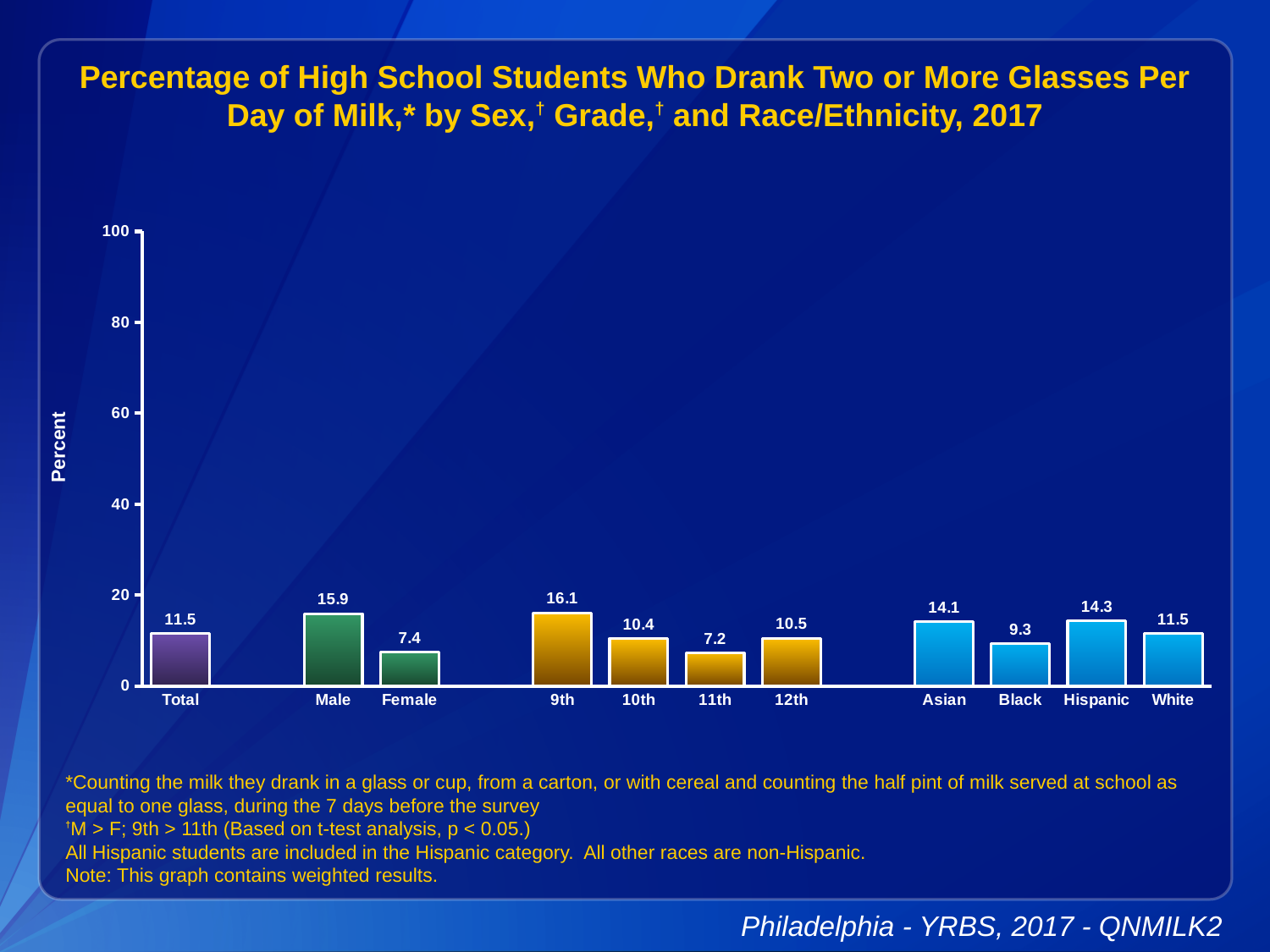
What is the value for Hispanic students? 14.3 What is the label on the vertical axis? Percent What percentage of female students drank two or more glasses of milk per day? 7.4 Which is larger, the value for Asian or the value for Black? Asian What is the difference between the values for Male and Female? 8.5 What is the value for 9th grade? 16.1 Which category has the highest value on the chart? 9th Is the value for 12th grade greater or less than 20? less How many categories are shown on the chart? 11 What kind of chart is shown on the slide? bar chart What is the value for Total? 11.5 Which category has the lowest value on the chart? 11th